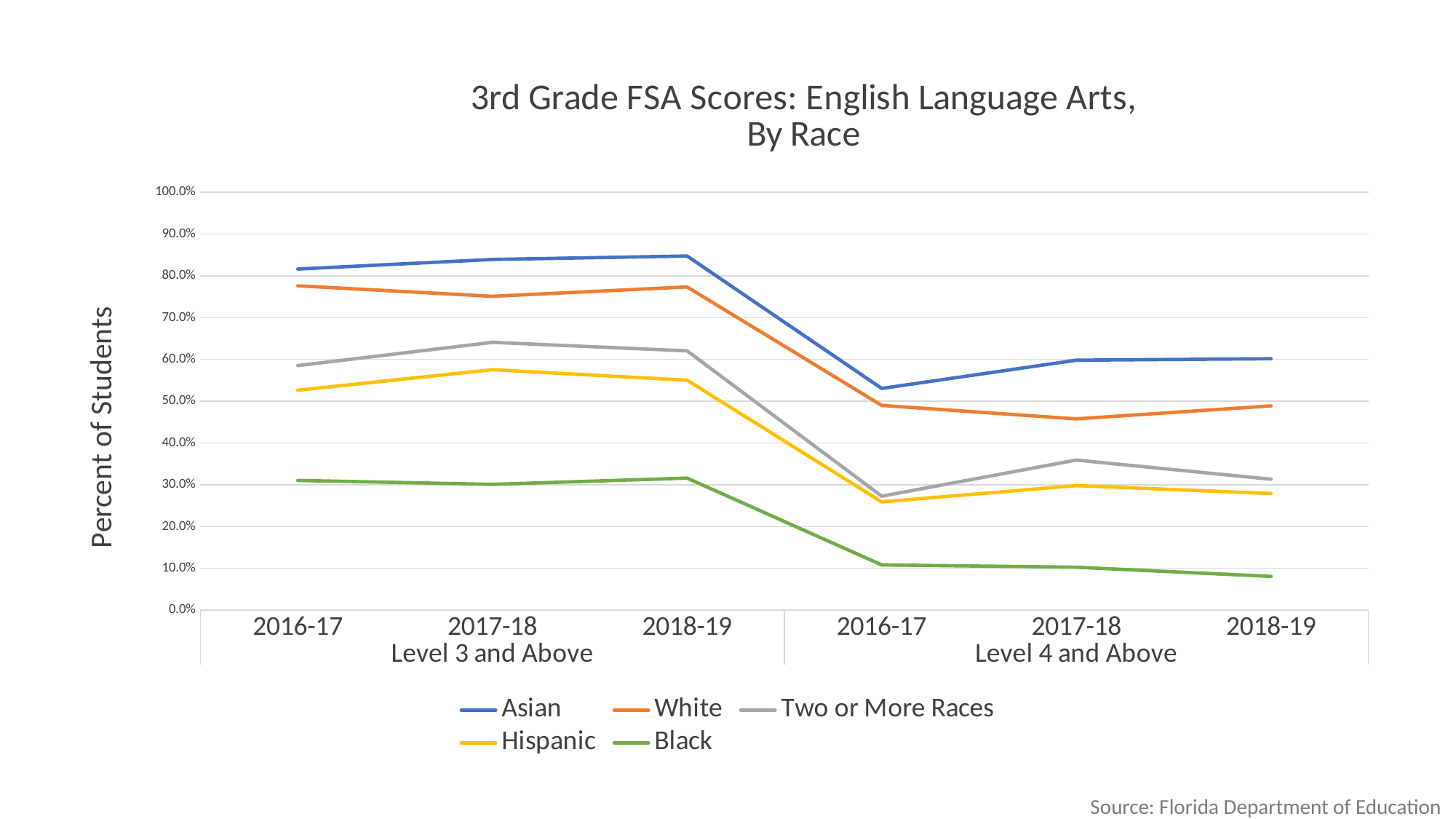
Is the value for Black in 2018-19, Level 4 and Above, greater or less than 10.0%? less What is the title of the vertical axis? Percent of Students Does the Black line rise or fall from 2016-17 to 2018-19 in the Level 4 and Above group? fall Which race has the lowest value for 2016-17 in the Level 4 and Above group? Black Is the value for Two or More Races in 2017-18, Level 3 and Above, greater or less than 60.0%? greater What kind of chart is shown on the slide? line chart How many points are plotted along the x axis for each series? 6 In 2017-18, Level 4 and Above, which is larger: the value for White or the value for Two or More Races? White Is the value for White in 2017-18, Level 4 and Above, greater or less than 50.0%? less Which race has the highest value for 2018-19 in the Level 3 and Above group? Asian How many series does the legend list? 5